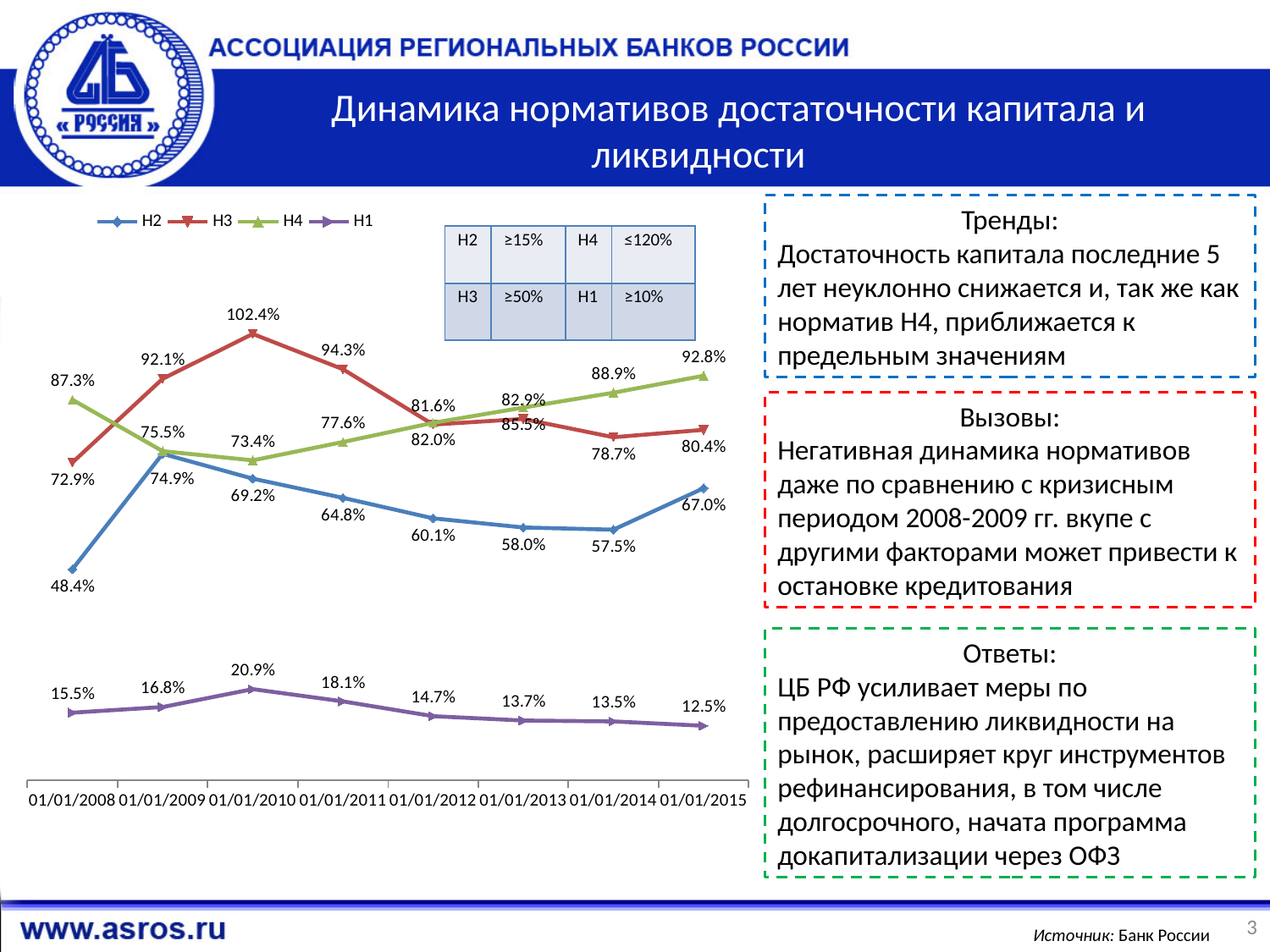
What kind of chart is shown on the slide? Line chart On which date is Н2 at its lowest value? 01/01/2008 By how many percentage points did Н4 change from 01/01/2008 (87.3%) to 01/01/2015 (92.8%)? 5.5 percentage points What is the value of Н1 on 01/01/2008? 15.5% Does Н1 rise or fall from 01/01/2012 to 01/01/2015? Fall What is the value of Н3 on 01/01/2010? 102.4% On which date does Н1 reach its highest value? 01/01/2010 What is the value of Н2 on 01/01/2015? 67.0% How many dates are plotted along the x axis of the chart? 8 How many series does the chart legend list? 4 Which series are listed in the chart legend? Н2, Н3, Н4, Н1 On 01/01/2014, which is larger: Н3 or Н4? Н4